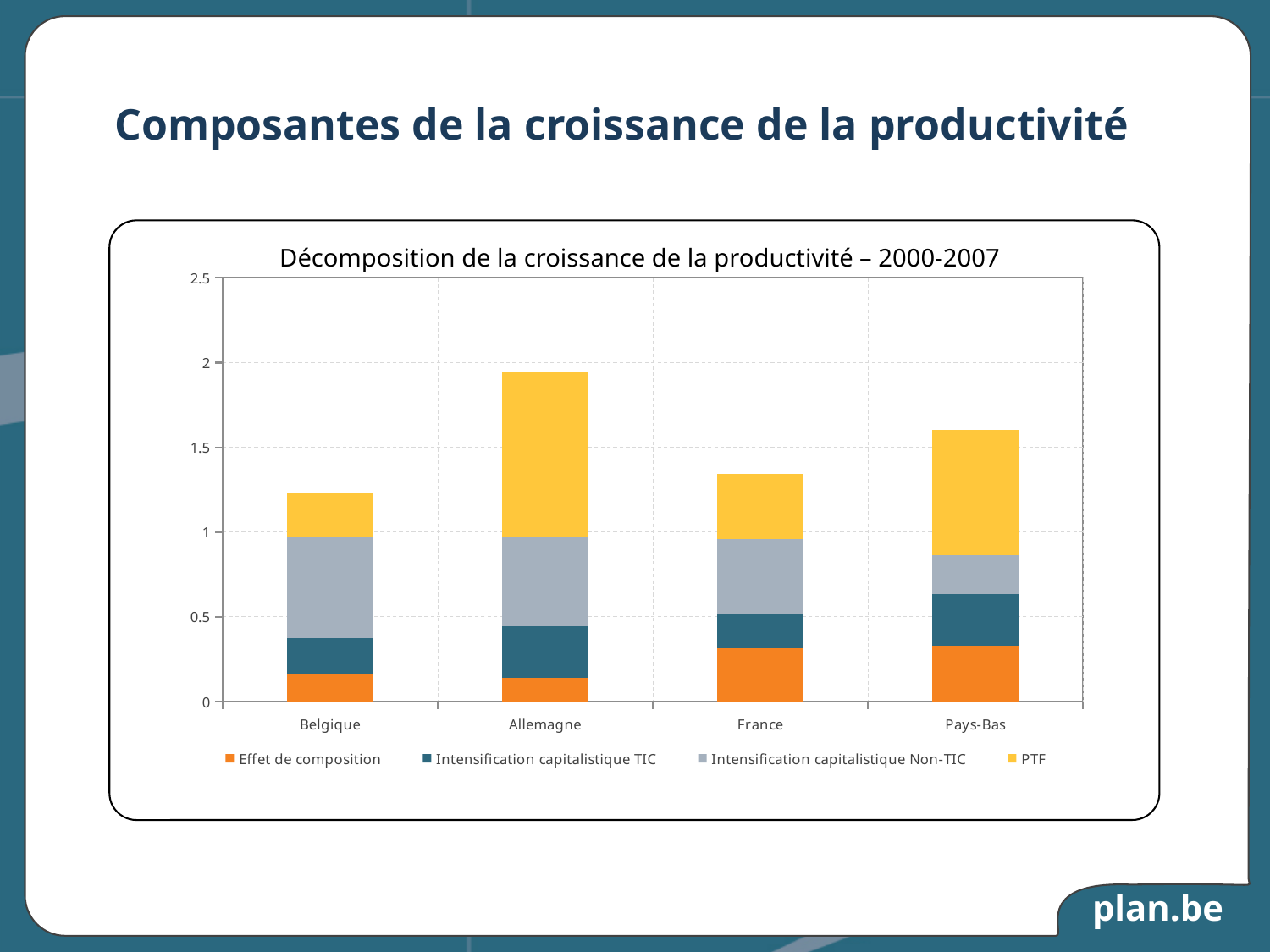
What is the title of the chart? Décomposition de la croissance de la productivité – 2000-2007 Is the total bar for France greater or less than 1.5? less How many series does the legend list? 4 Which country has the highest total bar in the chart? Allemagne Is the total bar for Allemagne greater or less than 1.5? greater Is the total bar for Belgique greater or less than 1.5? less Which series is shown in yellow in the chart? PTF What kind of chart is shown on the slide? stacked bar chart How many countries are shown on the x axis of the chart? 4 Which has the larger total bar, Pays-Bas or Belgique? Pays-Bas Which has the larger total bar, Allemagne or France? Allemagne